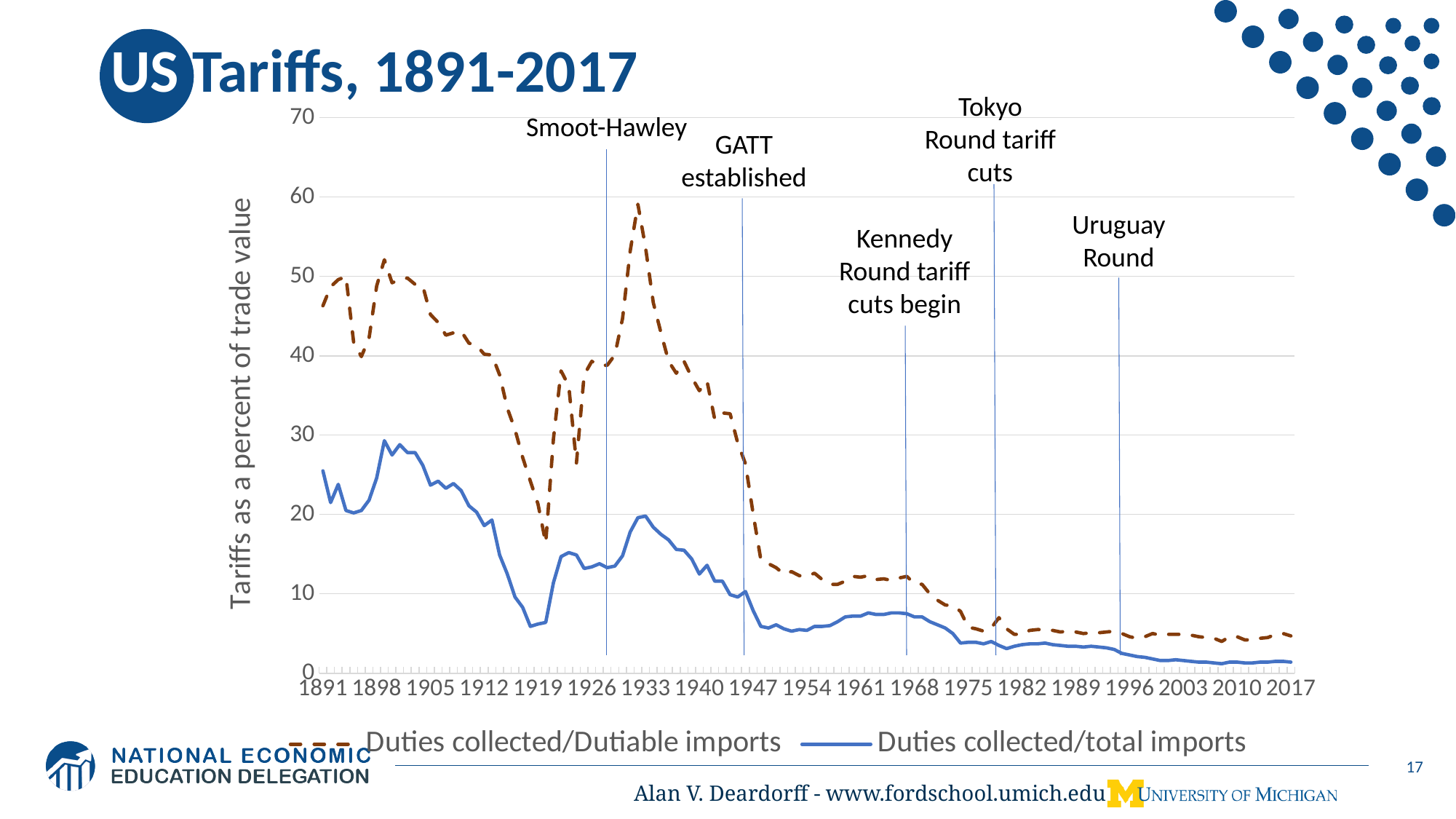
How many year labels are shown on the x axis? 19 Is the peak value of Duties collected/Dutiable imports around 1933 greater or less than 50? greater What is the title of the chart? US Tariffs, 1891-2017 What are the two series named in the legend? Duties collected/Dutiable imports; Duties collected/total imports What kind of chart is shown on the slide? line chart Is the value for Duties collected/Dutiable imports in 2017 greater or less than 10? less Is the value for Duties collected/total imports in 2017 greater or less than 10? less Overall, do the tariff values rise or fall from 1891 to 2017? fall Which series is higher in 1933, Duties collected/Dutiable imports or Duties collected/total imports? Duties collected/Dutiable imports How many series does the legend list? 2